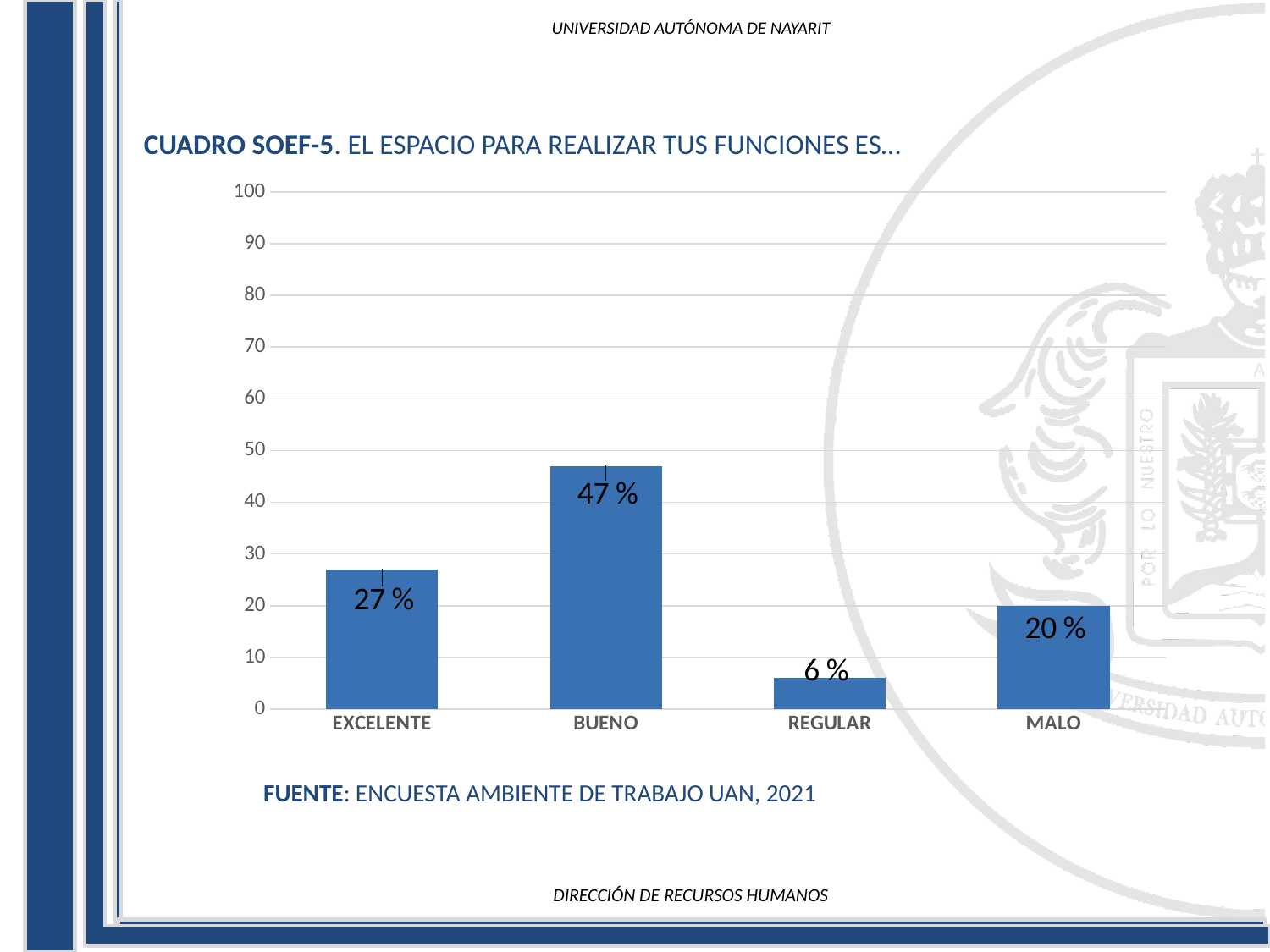
Is the value for BUENO greater or less than 50? less Which is larger, the value for EXCELENTE or the value for MALO? EXCELENTE Which category has the highest value? BUENO What is the value for EXCELENTE? 27 % Which category has the lowest value? REGULAR What is the difference between the values for BUENO and EXCELENTE? 20 % What is the value for MALO? 20 % How many categories are shown on the x axis? 4 What is the value for BUENO? 47 % What is the value for REGULAR? 6 % What is the source cited below the chart? ENCUESTA AMBIENTE DE TRABAJO UAN, 2021 What kind of chart is shown on the slide? bar chart